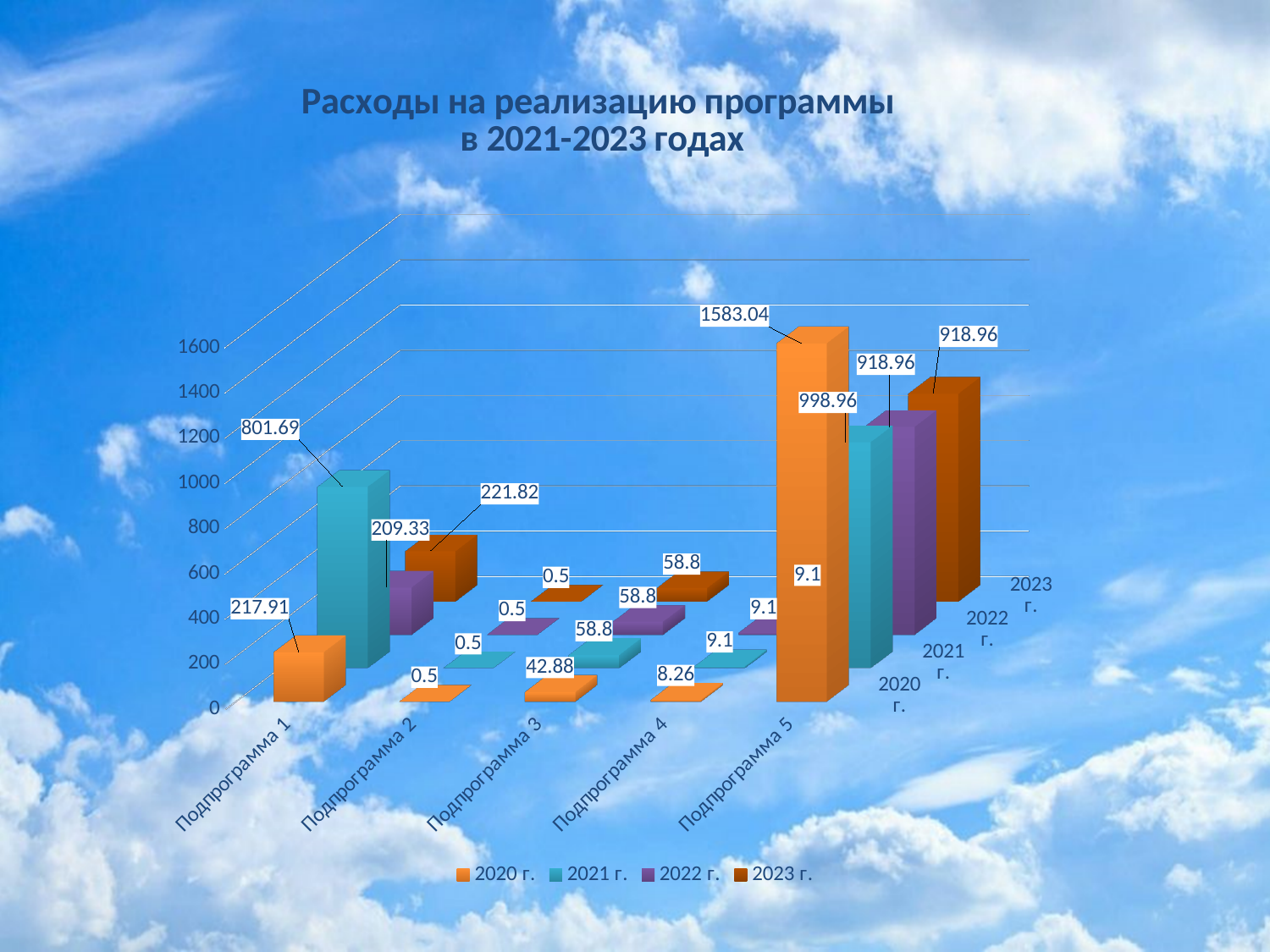
How many series does the legend list? 4 What is the value for Подпрограмма 3 in the 2020 г. series? 42.88 Which is larger for Подпрограмма 1: the 2022 г. value or the 2023 г. value? 2023 г. What is the value for Подпрограмма 5 in the 2020 г. series? 1583.04 What is the value for Подпрограмма 4 in the 2023 г. series? 9.1 What is the title of the chart? Расходы на реализацию программы в 2021-2023 годах Which subprogram has the highest value in the 2020 г. series? Подпрограмма 5 How many subprogram categories are shown on the x axis? 5 What type of chart is shown on the slide? bar chart What is the difference between the 2020 г. and 2021 г. values for Подпрограмма 5? 584.08 What is the value for Подпрограмма 1 in the 2021 г. series? 801.69 Which subprogram has the lowest value in the 2023 г. series? Подпрограмма 2